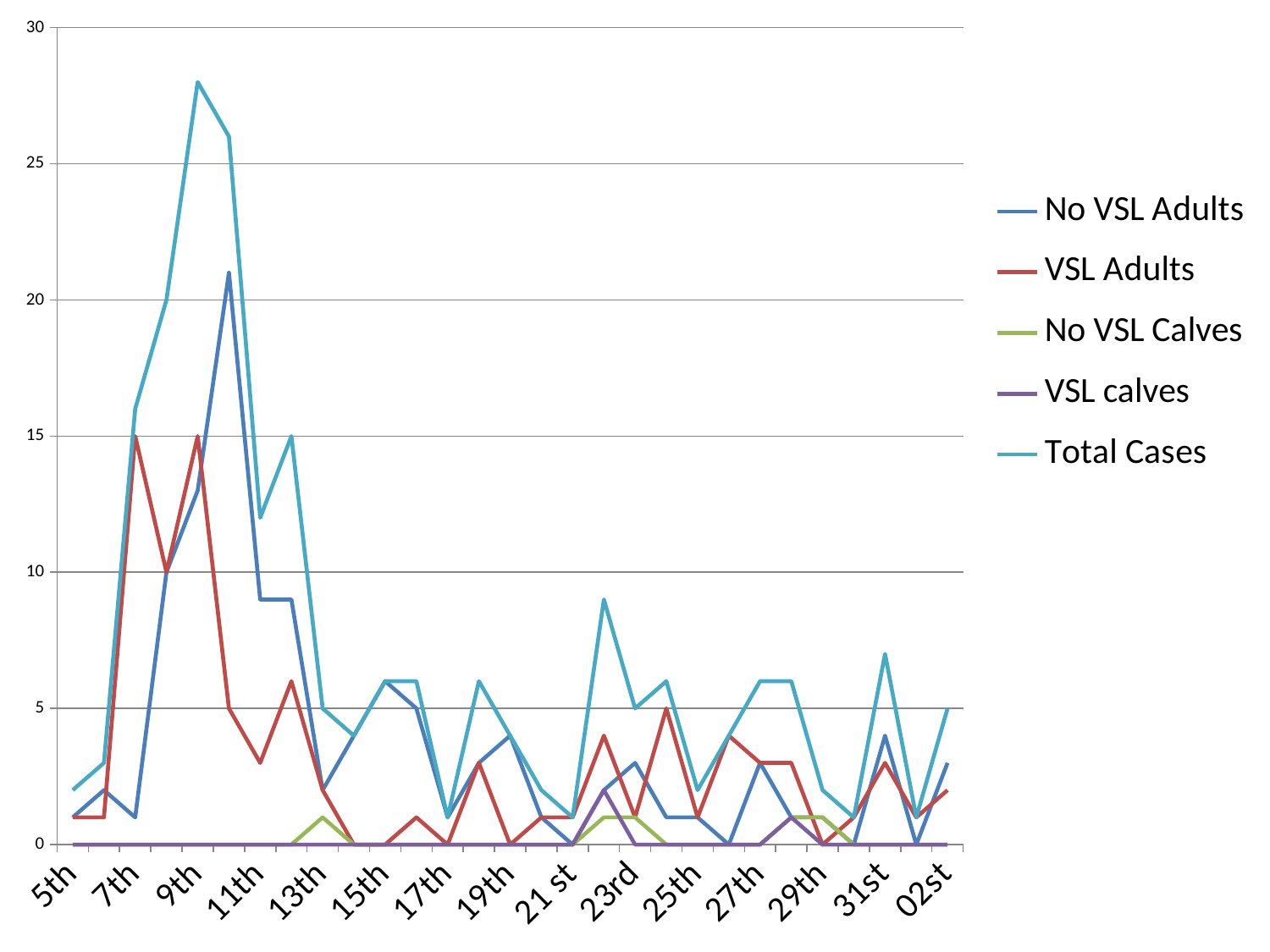
Is the value of Total Cases on the 9th greater or less than 25? greater On which date does Total Cases reach its highest value? 9th How many series does the legend list? 5 Which series is drawn in red? VSL Adults Does Total Cases rise or fall from the 9th to the 13th? fall What kind of chart is shown on the slide? line chart On the 7th, which is larger: VSL Adults or No VSL Adults? VSL Adults What is the value of Total Cases on the 13th? 5 Is the value of No VSL Adults on the 11th greater or less than 20? less How many labels are shown along the x axis? 15 What is the value of VSL Adults on the 7th? 15